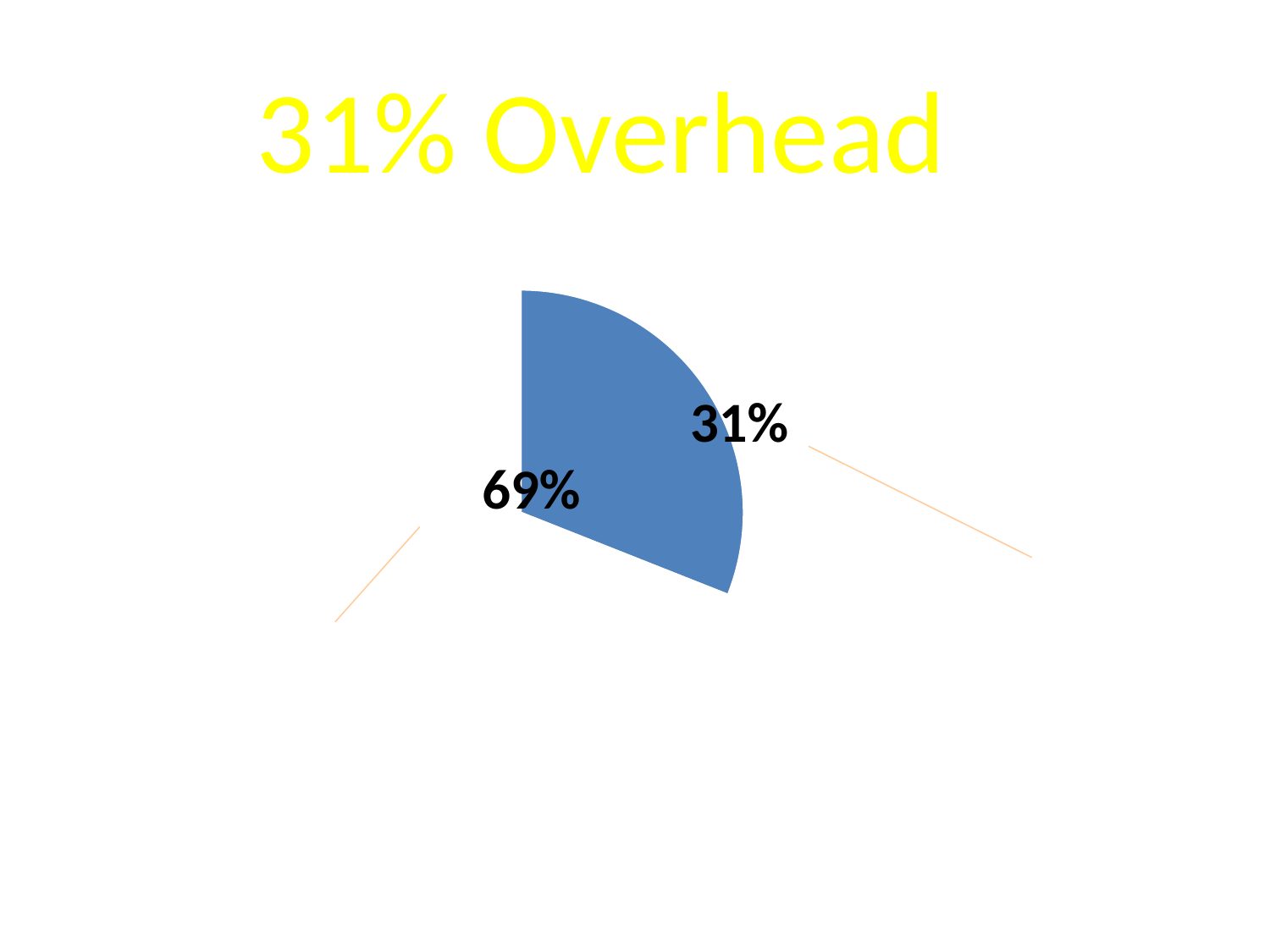
What is the value of the smallest slice in the pie chart? 31% What share of the pie does the blue slice represent? 31% What is the value of the largest slice in the pie chart? 69% What is the difference between the two slice values in the pie chart? 38% What kind of chart is shown on the slide? pie chart Is the value of the blue slice greater or less than 50%? less How many slices does the pie chart have? 2 What colour is the slice labelled 31%? blue What percentage is shown on the blue slice of the pie chart? 31% Which slice is larger, the one labelled 31% or the one labelled 69%? 69% What is the title of the slide above the pie chart? 31% Overhead